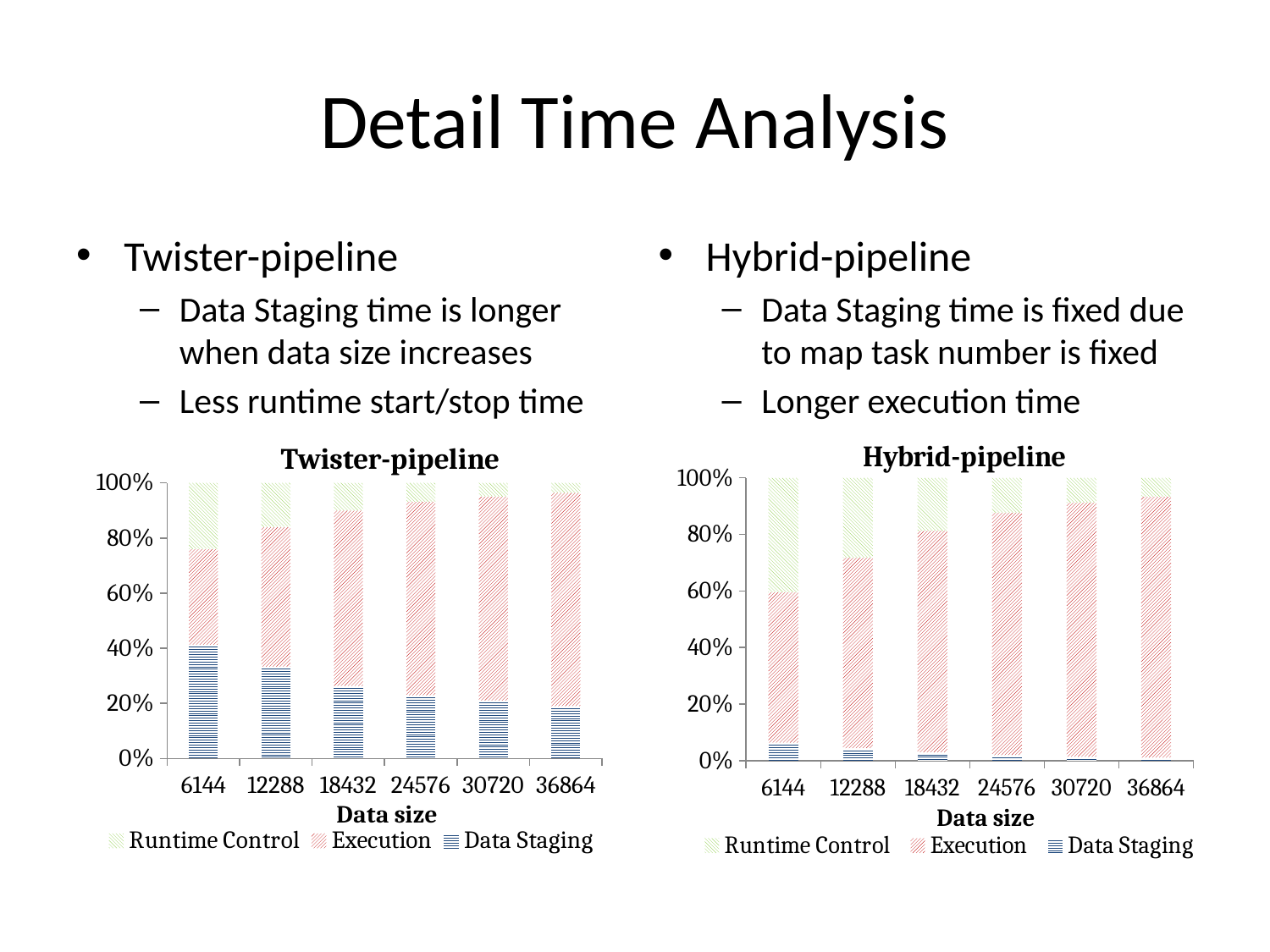
In the Twister-pipeline chart, is the Data Staging share at 12288 greater or less than 20%? greater How many series does the legend of the Twister-pipeline chart list? 3 In the Hybrid-pipeline chart, does the Execution share rise or fall as data size increases along the x axis? Rise What is the x-axis title of the Hybrid-pipeline chart? Data size In the Hybrid-pipeline chart, is the Execution share at 36864 greater or less than 80%? greater In the Twister-pipeline chart, does the Data Staging share rise or fall as data size increases along the x axis? Fall How many data size categories are shown on the x axis of the Hybrid-pipeline chart? 6 In the Hybrid-pipeline chart, is the Data Staging share at 6144 greater or less than 20%? less What kind of chart is the Twister-pipeline chart? Stacked bar chart In the Twister-pipeline chart, at which data size is the Data Staging share the highest? 6144 In the Twister-pipeline chart, is the Data Staging share larger at 6144 or at 36864? 6144 Which series are listed in the legend of the Hybrid-pipeline chart? Runtime Control, Execution, Data Staging